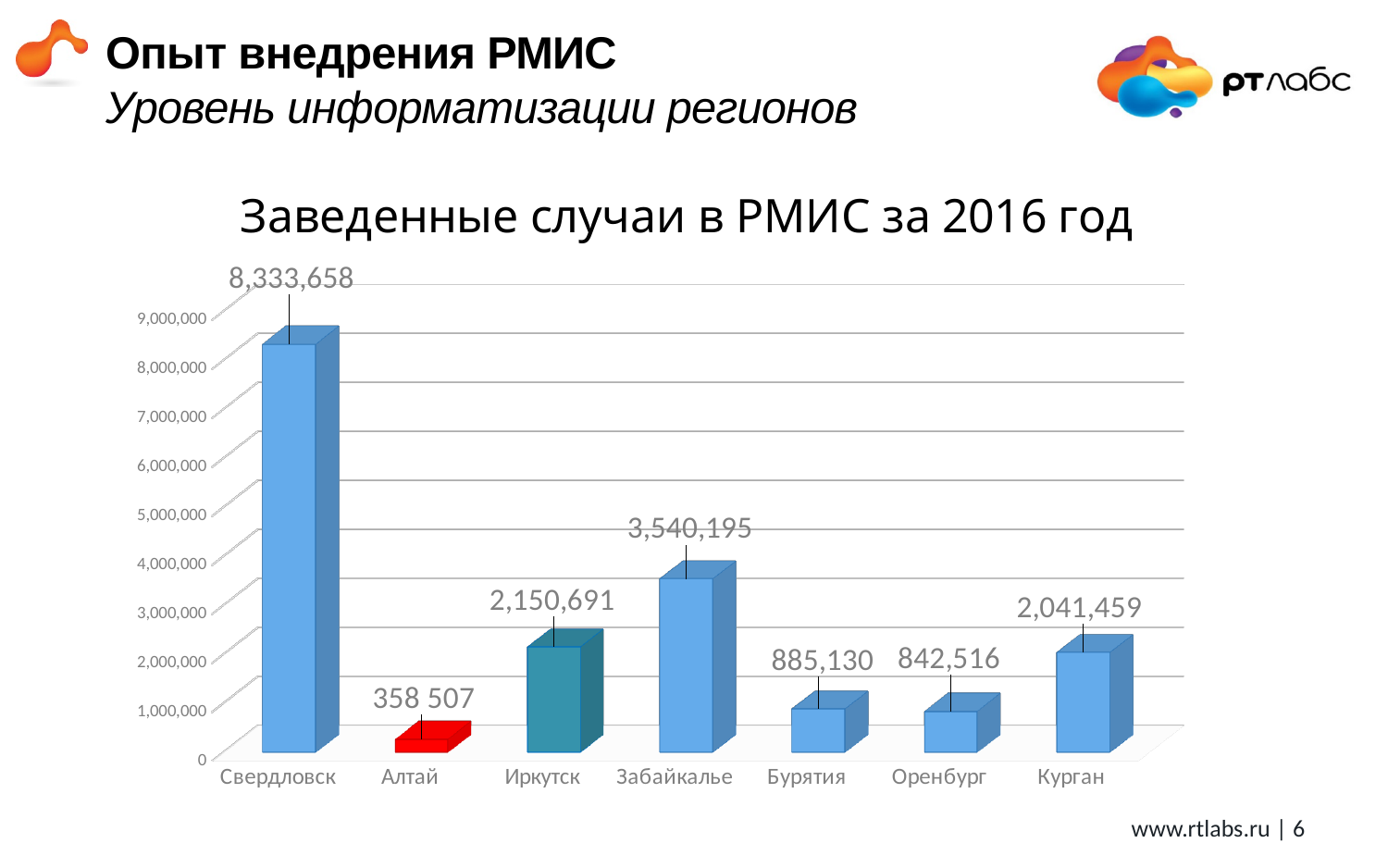
What kind of chart is this? Bar chart What is the value for Свердловск? 8,333,658 What is the difference between the values for Бурятия and Оренбург? 42,614 What is the difference between the values for Забайкалье and Иркутск? 1,389,504 What is the value for Курган? 2,041,459 What is the value for Алтай? 358 507 Which region has the highest value? Свердловск What is the title of the chart? Заведенные случаи в РМИС за 2016 год What is the value for Забайкалье? 3,540,195 How many regions are shown on the chart? 7 Which is larger, the value for Иркутск or the value for Курган? Иркутск Which region has the lowest value? Алтай